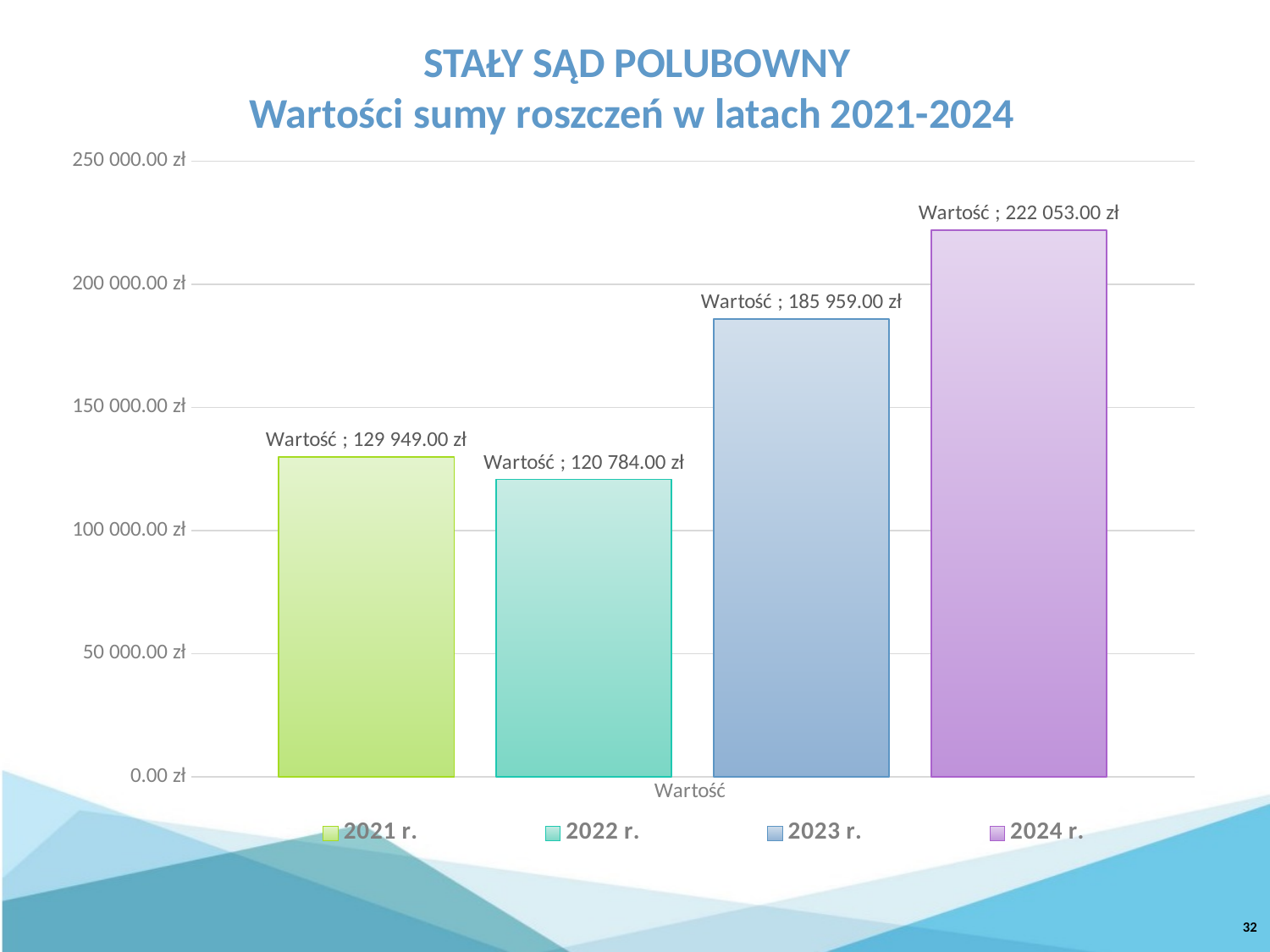
What is the value shown for 2021 r.? 129 949.00 zł What is the value shown for 2022 r.? 120 784.00 zł What is the difference between the values for 2024 r. and 2023 r.? 36 094.00 zł How many series does the legend list? 4 Which year has the lowest value? 2022 r. Which year has the highest value? 2024 r. Which is larger, the value for 2021 r. or the value for 2023 r.? 2023 r. What kind of chart is shown on the slide? bar chart What is the value shown for 2024 r.? 222 053.00 zł Is the value for 2023 r. greater or less than 200 000.00 zł? less What is the value shown for 2023 r.? 185 959.00 zł What is the difference between the values for 2021 r. and 2022 r.? 9 165.00 zł